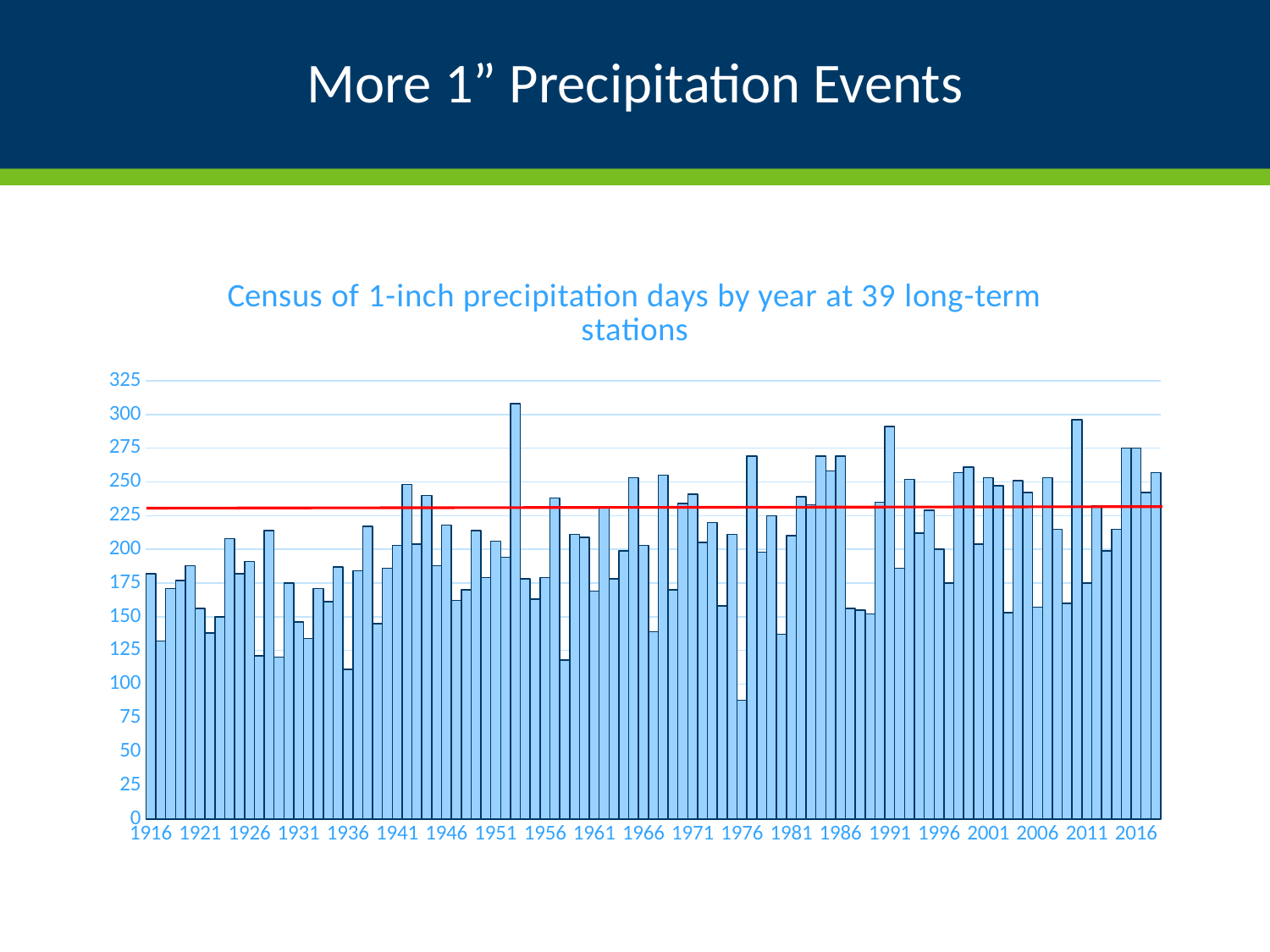
What colour is the horizontal reference line drawn across the chart? red Do the values generally rise or fall from 1916 to 2016 along the x axis? rise Is the value for 2016 greater or less than 250? greater Which is larger, the value for 1991 or the value for 1986? 1991 What kind of chart is shown on the slide? bar chart Which labelled year on the x axis has the lowest bar? 1976 Is the value for 2011 greater or less than 275? less Is the value for 1936 greater or less than 125? less What is the title of the chart? Census of 1-inch precipitation days by year at 39 long-term stations